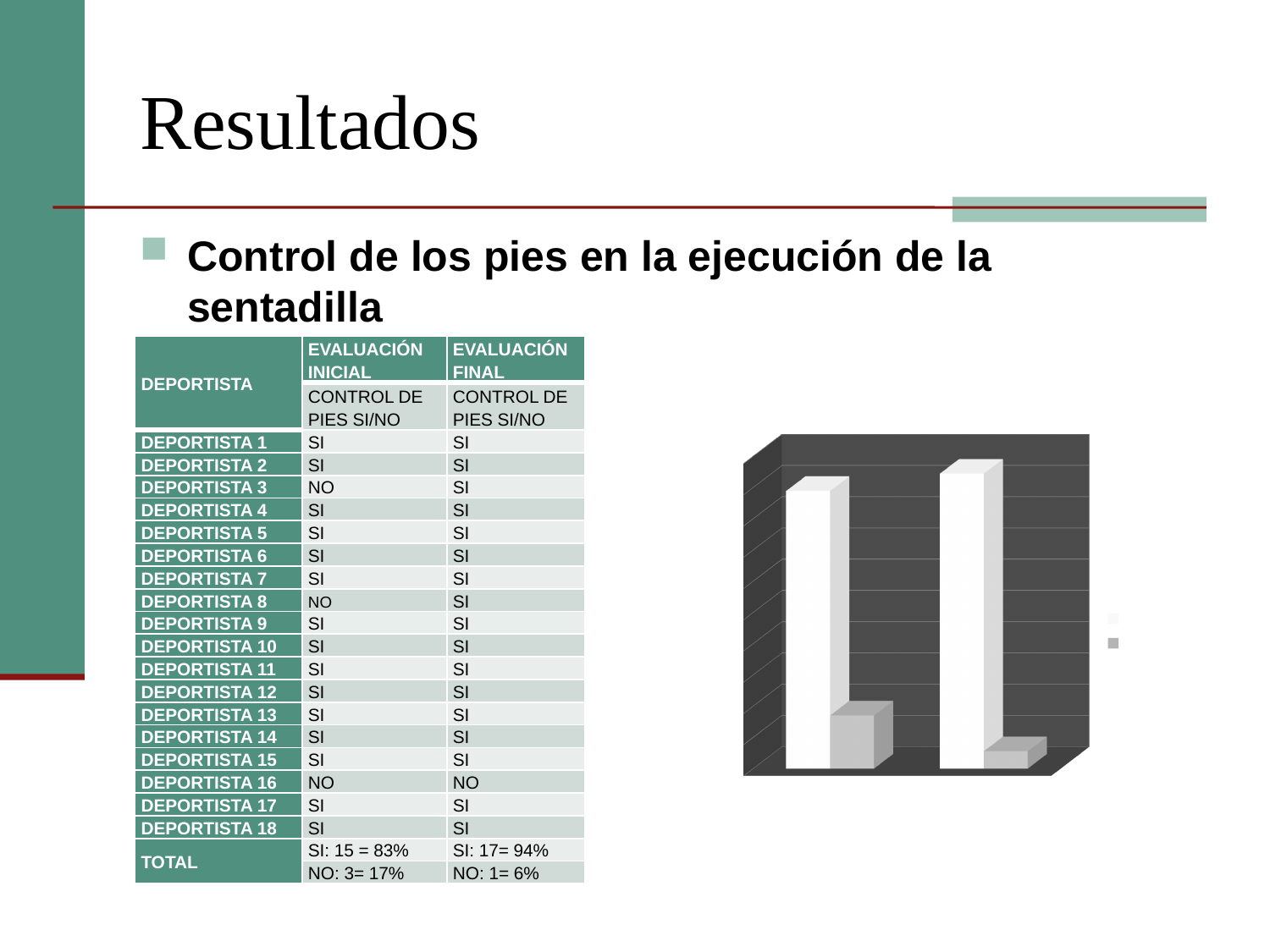
In the chart on the right side of the slide, is the white bar or the grey bar taller in the left group? the white bar How many groups of bars does the chart on the right side of the slide contain? 2 What kind of chart is shown on the right side of the slide? bar chart In the chart on the right side of the slide, which bar is the shortest? the grey bar in the right group In the chart on the right side of the slide, is the grey bar in the left group taller or shorter than the grey bar in the right group? taller How many bars are plotted in the chart on the right side of the slide? 4 In the chart on the right side of the slide, which bar is the tallest? the white bar in the right group How many entries does the legend of the chart on the right side of the slide show? 2 What colours are the two series in the chart on the right side of the slide? white and grey In the chart on the right side of the slide, is the white bar or the grey bar taller in the right group? the white bar